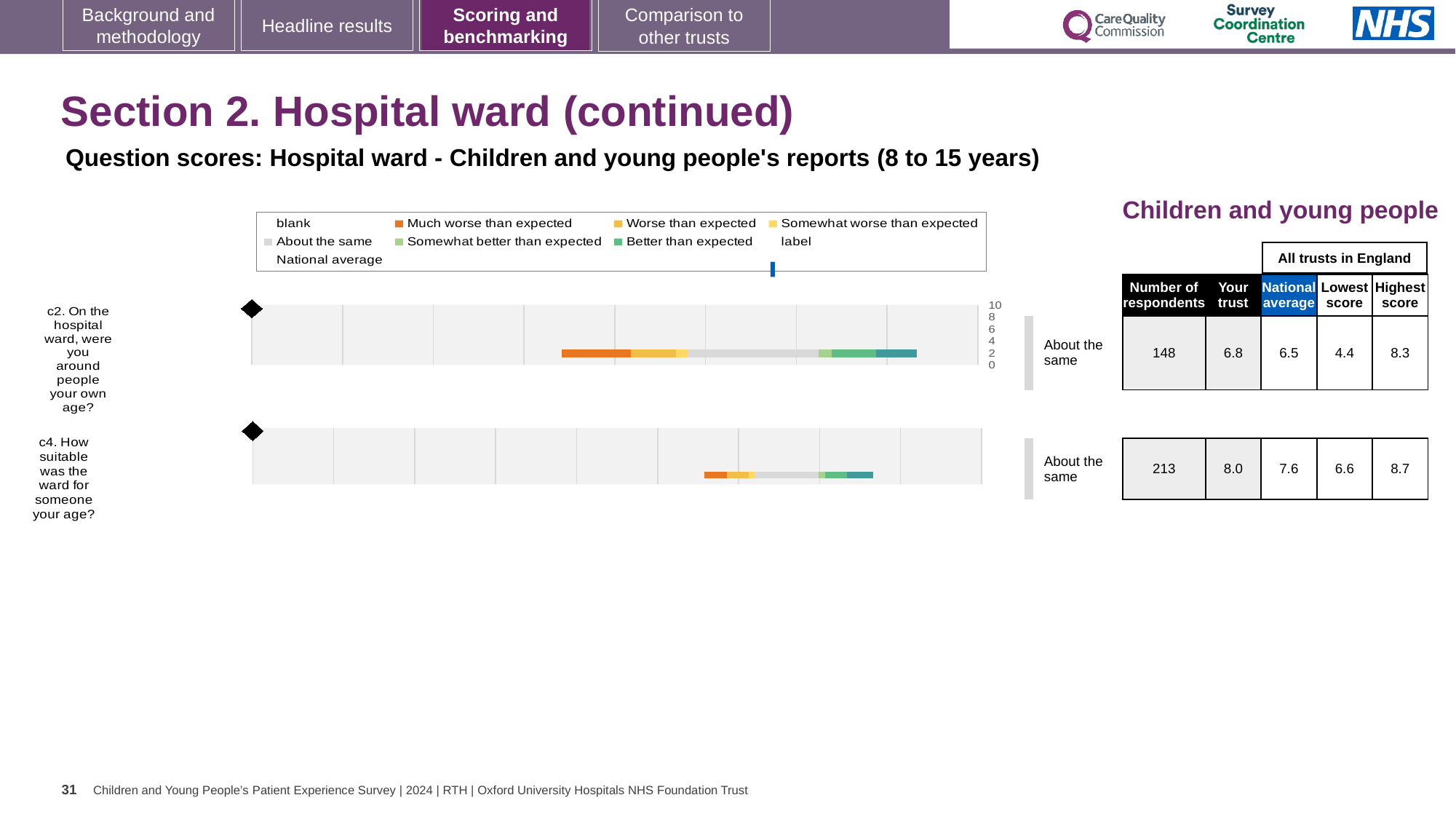
How many respondents answered question c2? 148 How many questions are plotted on the slide? 2 What is the lowest score among all trusts in England for question c2? 4.4 Which question has the higher 'Your trust' score, c2 or c4? c4 What is the 'Your trust' score for question c2 (On the hospital ward, were you around people your own age?)? 6.8 What kind of chart is used to show the question scores? Bar chart What is the national average score for question c4 (How suitable was the ward for someone your age?)? 7.6 What benchmark category is shown for question c2? About the same By how much does the trust's score for question c4 exceed the national average? 0.4 What is the difference between the highest and lowest scores for question c2? 3.9 What is the highest score among all trusts in England for question c4? 8.7 Which question had more respondents, c2 or c4? c4